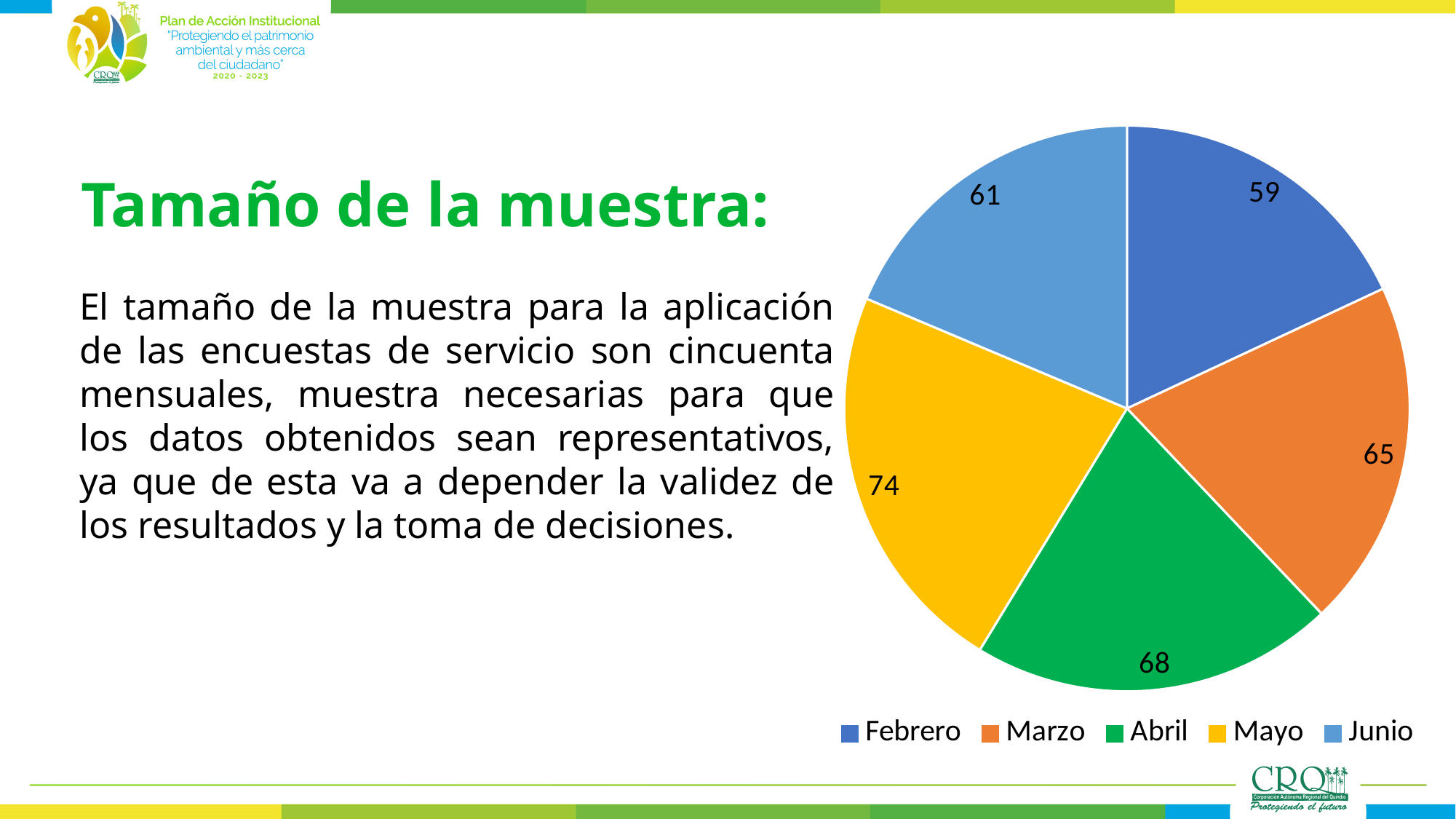
What is the value for Mayo in the pie chart? 74 What colour is the slice for Abril in the pie chart? Green What is the value for Febrero in the pie chart? 59 Which month has the smallest slice in the pie chart? Febrero Which is larger, the value for Marzo or the value for Junio? Marzo Which month has the largest slice in the pie chart? Mayo What is the difference between the values for Mayo and Febrero? 15 What kind of chart is shown on the slide? Pie chart How many slices does the pie chart have? 5 What is the difference between the values for Abril and Marzo? 3 What is the value for Junio in the pie chart? 61 What is the value for Abril in the pie chart? 68